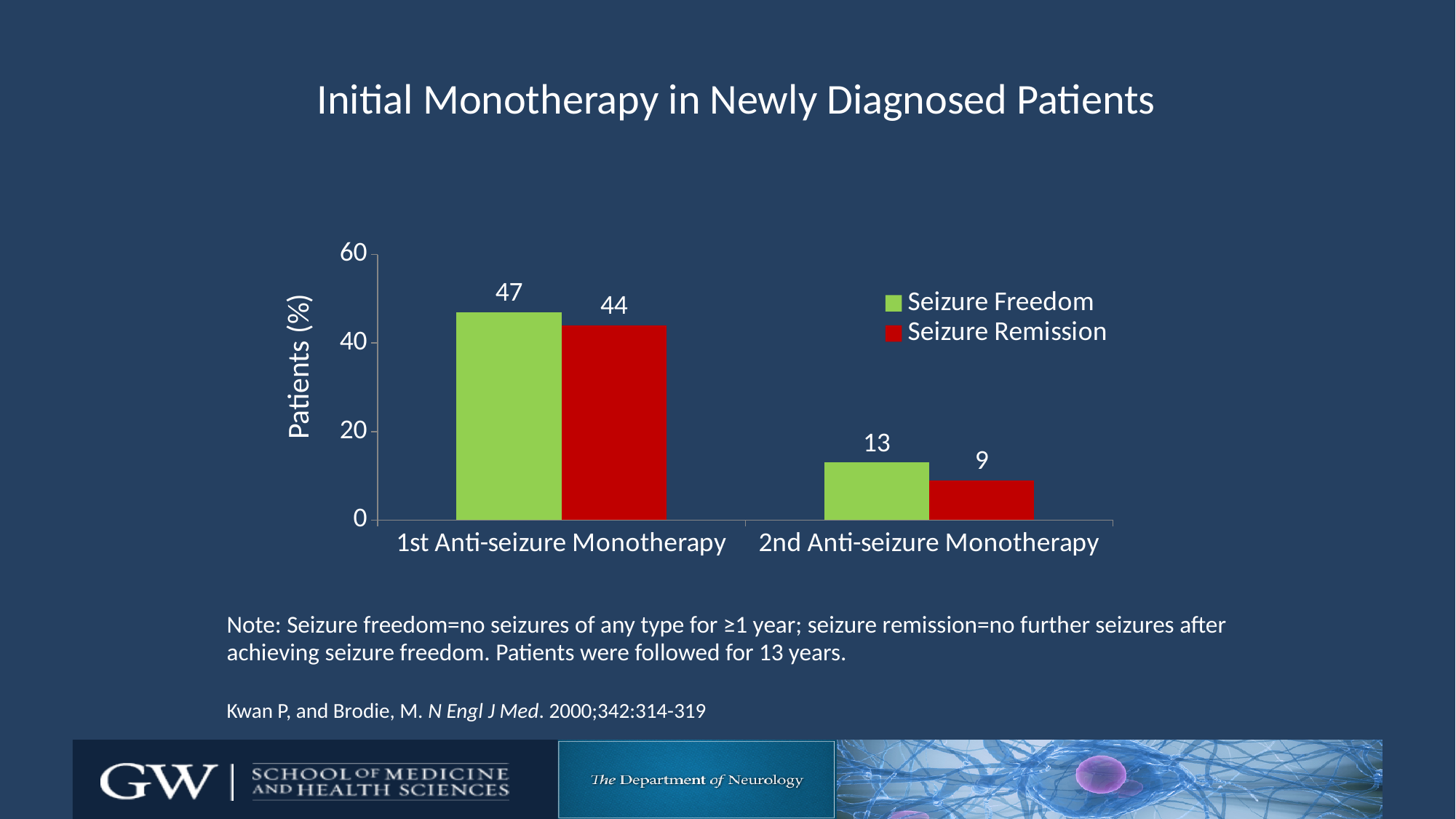
How many series does the legend list? 2 Which category has the highest Seizure Remission value? 1st Anti-seizure Monotherapy What is the Seizure Remission value for 2nd Anti-seizure Monotherapy? 9 Is the Seizure Remission value for 1st Anti-seizure Monotherapy greater or less than 40? greater How many categories are shown on the x axis? 2 What is the difference between Seizure Freedom and Seizure Remission for 1st Anti-seizure Monotherapy? 3 What is the difference between the Seizure Freedom values for 1st and 2nd Anti-seizure Monotherapy? 34 What is the Seizure Freedom value for 2nd Anti-seizure Monotherapy? 13 What is the Seizure Freedom value for 1st Anti-seizure Monotherapy? 47 Which category has the lowest Seizure Freedom value? 2nd Anti-seizure Monotherapy Which is larger for 2nd Anti-seizure Monotherapy: Seizure Freedom or Seizure Remission? Seizure Freedom What kind of chart is shown on the slide? Bar chart